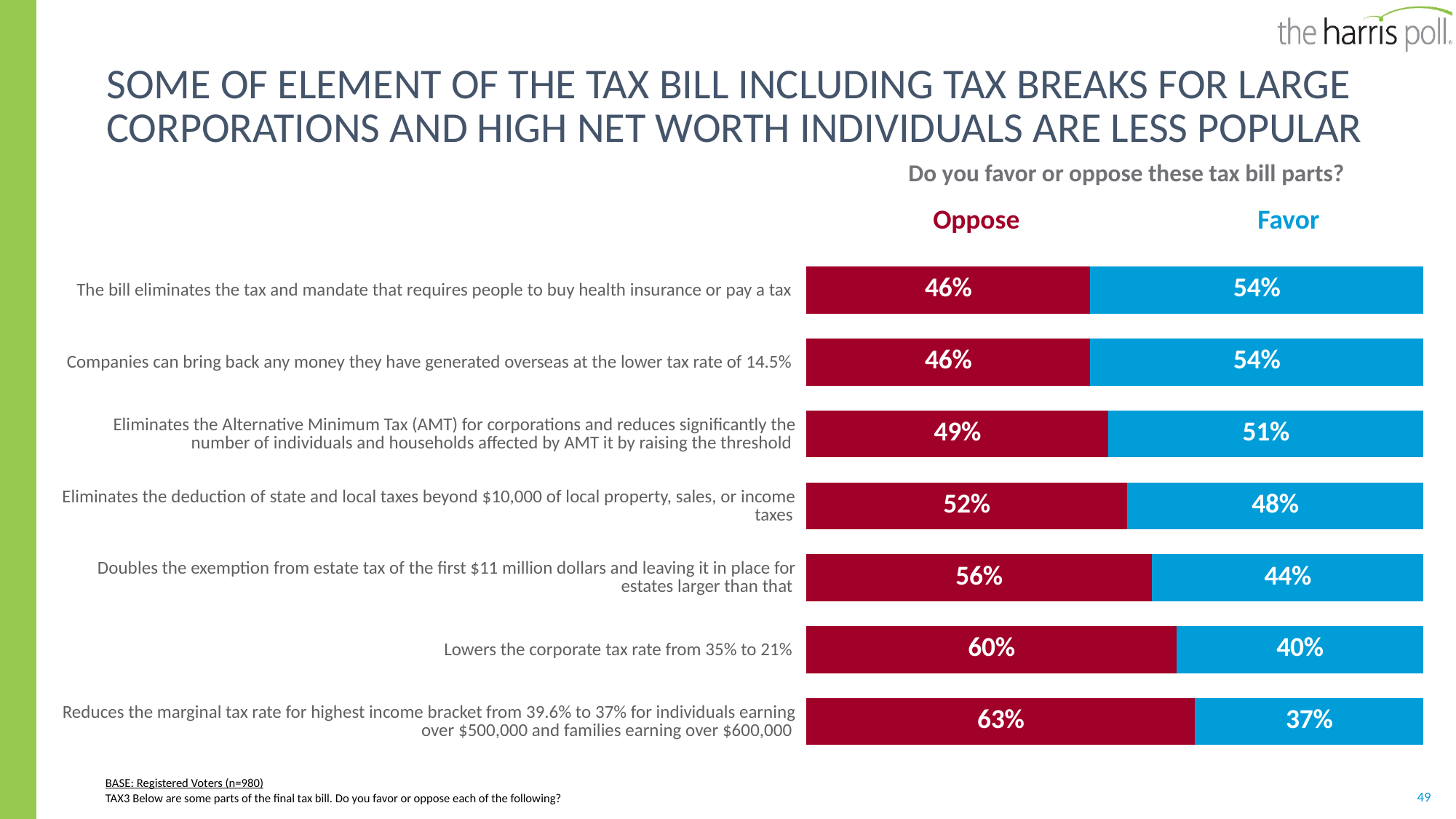
Which tax bill part has the lowest Favor percentage? Reduces the marginal tax rate for highest income bracket from 39.6% to 37% for individuals earning over $500,000 and families earning over $600,000 What colour represents the Favor series? Blue What kind of chart is shown on the slide? Stacked bar chart Is the Oppose percentage larger for eliminating the AMT for corporations or for doubling the estate tax exemption? Doubles the exemption from estate tax of the first $11 million dollars How many series does the chart show? 2 Which tax bill part has the highest Oppose percentage? Reduces the marginal tax rate for highest income bracket from 39.6% to 37% for individuals earning over $500,000 and families earning over $600,000 How many tax bill parts are shown in the chart? 7 What percentage favor doubling the exemption from estate tax of the first $11 million dollars? 44% What percentage favor the bill eliminating the tax and mandate that requires people to buy health insurance or pay a tax? 54% What percentage oppose eliminating the deduction of state and local taxes beyond $10,000? 52% What is the difference between the Oppose and Favor percentages for lowering the corporate tax rate from 35% to 21%? 20% What percentage oppose lowering the corporate tax rate from 35% to 21%? 60%